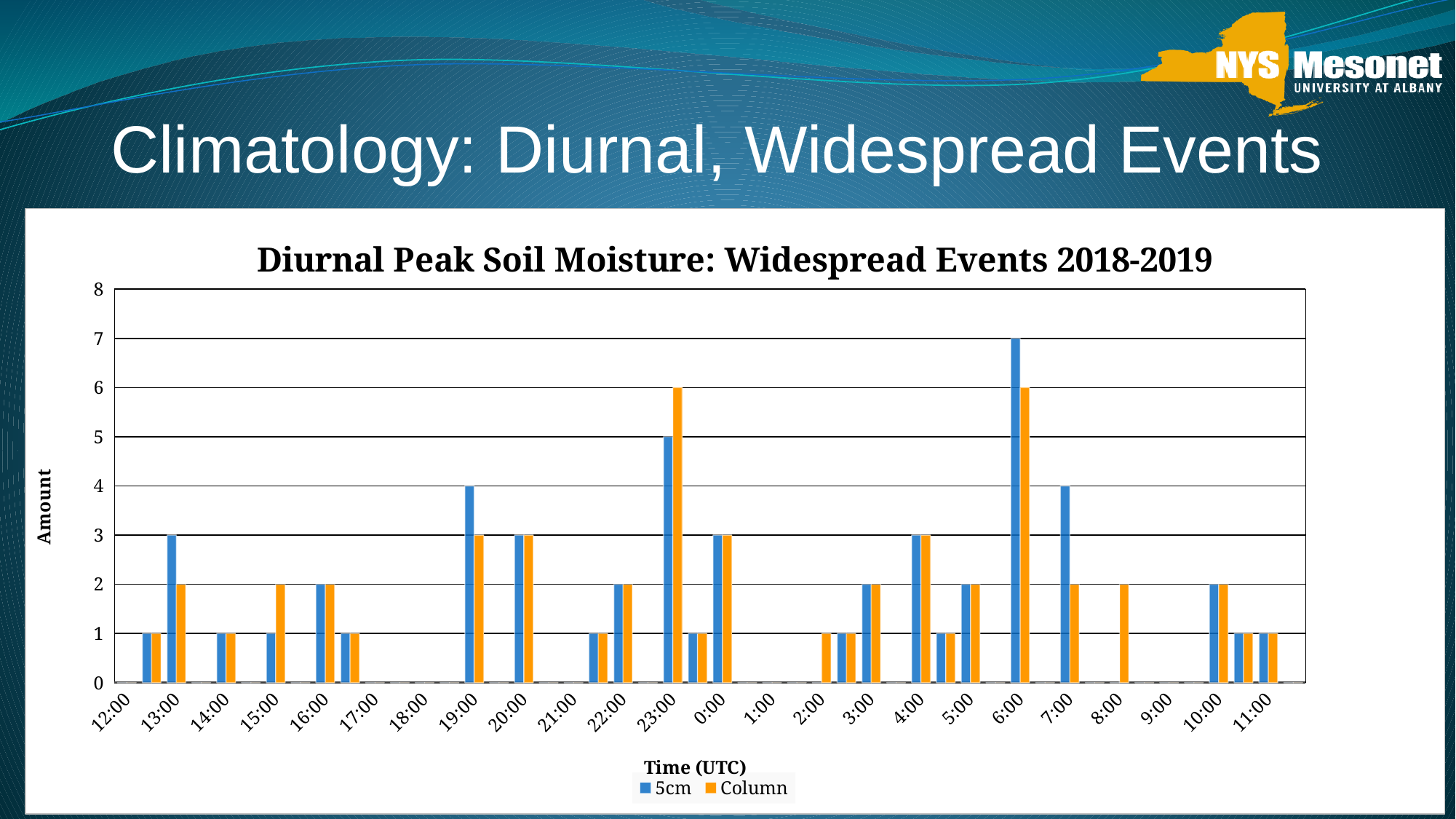
What is the 5cm value at 19:00? 4 What is the Column value at 23:00? 6 What type of chart is shown on the slide? Bar chart What is the Column value at 6:00? 6 How many series does the legend list? 2 What is the 5cm value at 6:00? 7 What is the title of the chart? Diurnal Peak Soil Moisture: Widespread Events 2018-2019 At which time is the 5cm series highest? 6:00 What are the two series named in the legend? 5cm and Column What is the difference between the 5cm and Column values at 7:00? 2 At 23:00, which series has the larger value, 5cm or Column? Column Is the 5cm value at 6:00 greater or less than 5? greater